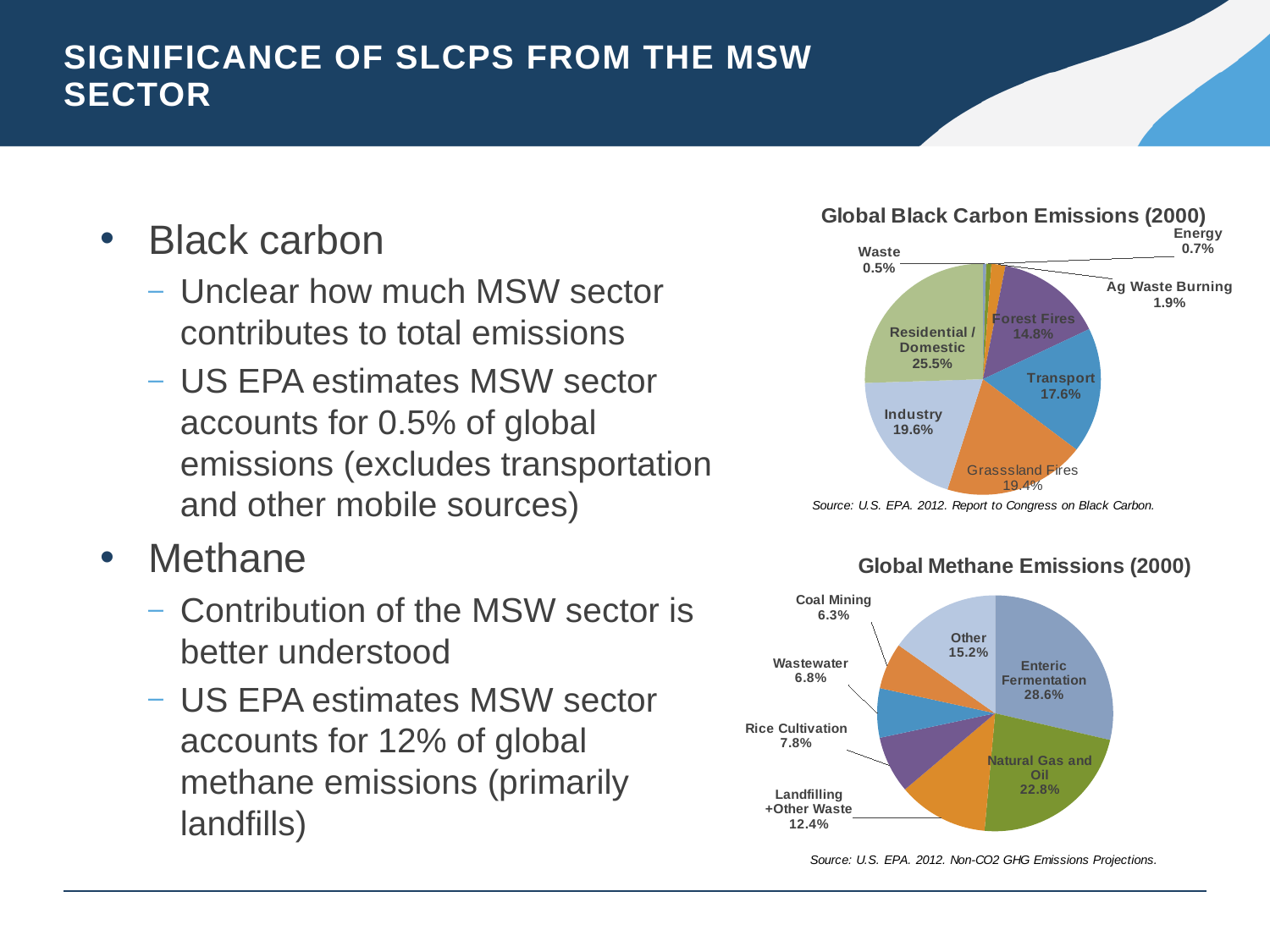
In the Global Methane Emissions (2000) chart, how many categories are shown? 7 In the Global Methane Emissions (2000) chart, what share is attributed to Landfilling +Other Waste? 12.4% In the Global Black Carbon Emissions (2000) chart, which category has the smallest share? Waste In the Global Black Carbon Emissions (2000) chart, what share is attributed to Residential / Domestic? 25.5% In the Global Black Carbon Emissions (2000) chart, what is the difference between the Transport and Forest Fires shares? 2.8% In the Global Black Carbon Emissions (2000) chart, which category has the largest share? Residential / Domestic In the Global Black Carbon Emissions (2000) chart, how many categories are shown? 8 In the Global Methane Emissions (2000) chart, what share is attributed to Enteric Fermentation? 28.6% In the Global Black Carbon Emissions (2000) chart, what share is attributed to Waste? 0.5% What type of chart is the Global Methane Emissions (2000) chart? Pie chart In the Global Methane Emissions (2000) chart, which is larger: Natural Gas and Oil or Other? Natural Gas and Oil In the Global Methane Emissions (2000) chart, which category has the smallest share? Coal Mining